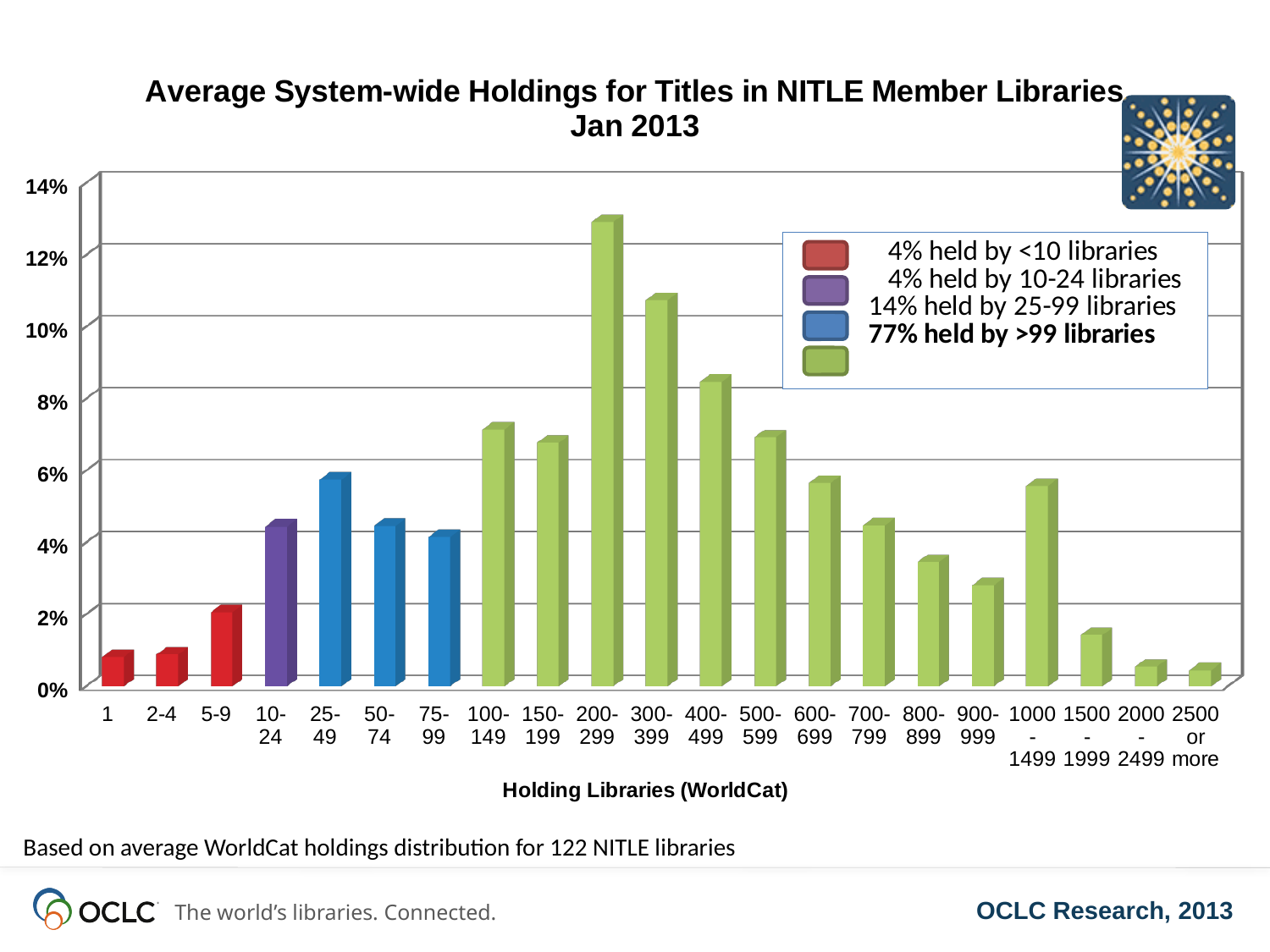
Which is larger, the value for 25-49 or the value for 50-74? 25-49 What kind of chart is shown on the slide? bar chart Is the value for the 1000-1499 category greater or less than 4%? greater According to the legend, what percentage of titles is held by more than 99 libraries? 77% Which is larger, the value for 300-399 or the value for 400-499? 300-399 Is the value for the 200-299 category greater or less than 12%? greater Do the values rise or fall along the x axis from the 200-299 category to the 900-999 category? fall Is the value for the 25-49 category greater or less than 6%? less How many holding-library categories are shown along the x axis? 21 Which holding-library category has the highest value? 200-299